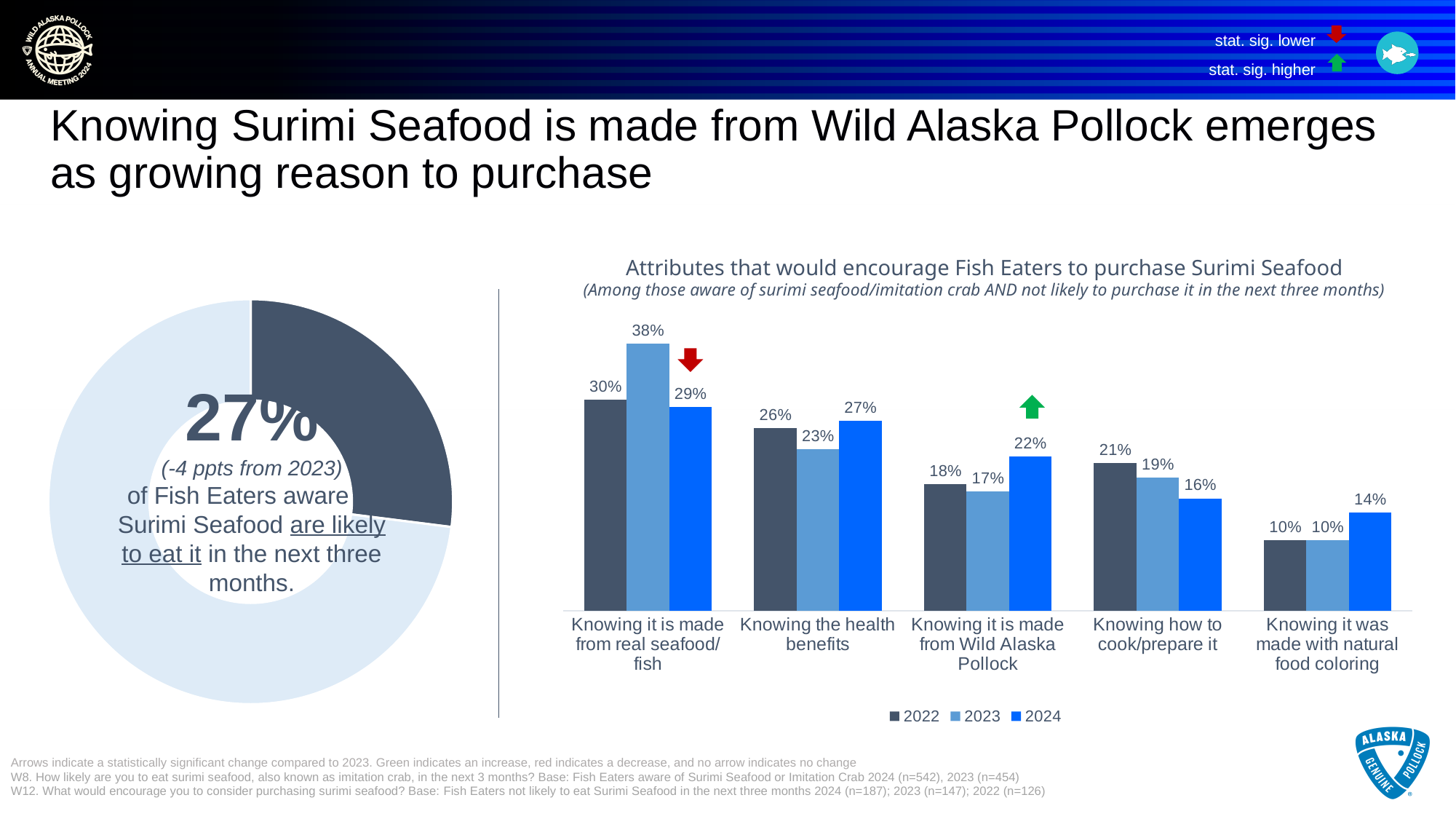
On the bar chart, which attribute has the highest 2024 value? Knowing it is made from real seafood/fish How many series does the legend of the bar chart list? 3 On the bar chart, which attribute has the lowest 2022 value? Knowing it was made with natural food coloring On the bar chart, which is larger for 'Knowing the health benefits': the 2022 value or the 2023 value? 2022 What kind of chart is the chart on the right side of the slide? bar chart On the bar chart, what is the 2023 value for 'Knowing it is made from real seafood/fish'? 38% How many attribute categories are shown on the bar chart? 5 On the bar chart, which attribute is marked with a green arrow indicating a statistically significant increase? Knowing it is made from Wild Alaska Pollock On the donut chart on the left, what share of Fish Eaters aware of Surimi Seafood are likely to eat it in the next three months? 27% On the bar chart, what is the difference between the 2023 and 2024 values for 'Knowing it is made from real seafood/fish'? 9% On the bar chart 'Attributes that would encourage Fish Eaters to purchase Surimi Seafood', what is the 2024 value for 'Knowing it is made from Wild Alaska Pollock'? 22% On the bar chart, what is the 2022 value for 'Knowing how to cook/prepare it'? 21%